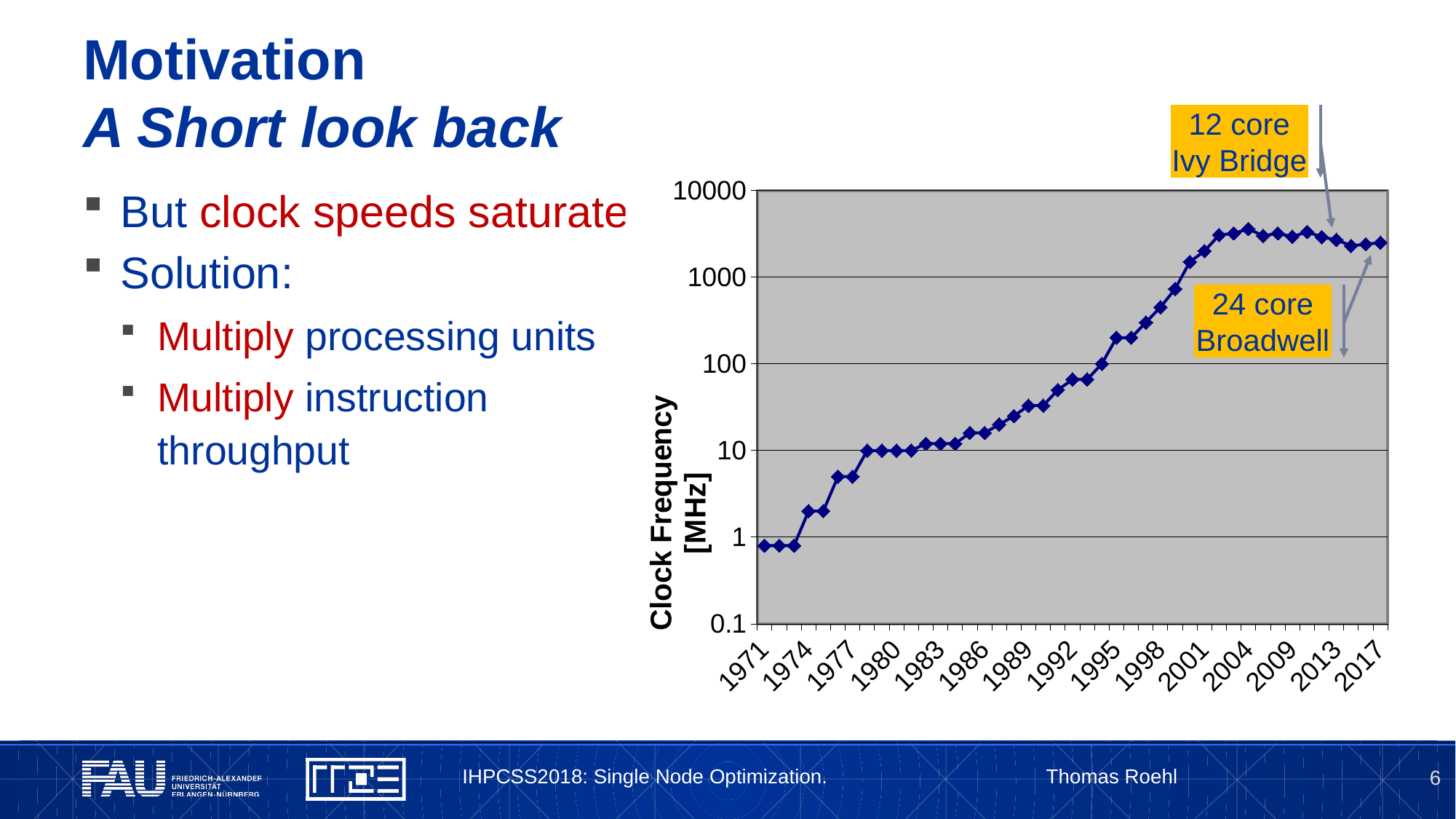
Is the clock frequency for 1986 greater or less than 10 MHz? greater How does the clock frequency change from 1971 to about 2004 along the x axis? it rises Is the clock frequency for 1971 greater or less than 1 MHz? less What is the label of the y axis of the chart? Clock Frequency [MHz] What kind of chart is shown on the slide? line chart Which is larger, the clock frequency in 1980 or in 1992? 1992 Is the clock frequency for 1995 greater or less than 100 MHz? greater Which two processors are called out with annotations on the chart? 12 core Ivy Bridge and 24 core Broadwell